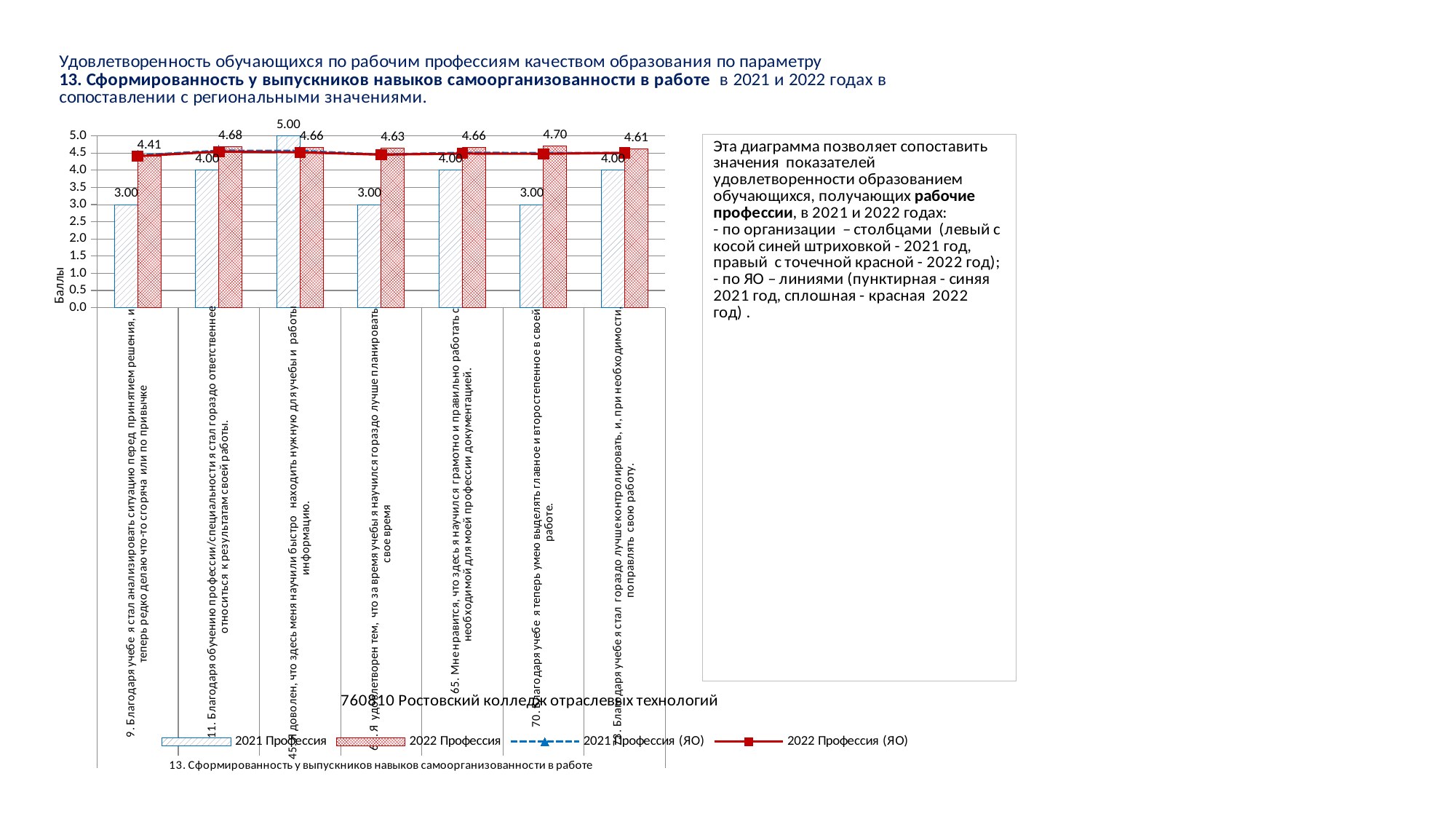
What is the value of the 2022 Профессия bar for category 9 (Благодаря учебе я стал анализировать ситуацию перед принятием решения)? 4.41 How many series does the chart legend list? 4 For category 9, what is the difference between the 2022 Профессия value and the 2021 Профессия value? 1.41 What is the value of the 2021 Профессия bar for category 45 (Я доволен, что здесь меня научили быстро находить нужную информацию)? 5.00 What is the value of the 2022 Профессия bar for category 65 (Мне нравится, что здесь я научился грамотно и правильно работать с документацией)? 4.66 What is the title of the vertical axis of the chart? Баллы For category 11, which is larger: the 2021 Профессия value or the 2022 Профессия value? 2022 Профессия For category 45, what is the difference between the 2021 Профессия value and the 2022 Профессия value? 0.34 Is the 2021 Профессия (ЯО) line value for category 9 greater or less than 4.0? greater How many categories are shown on the x axis of the chart? 7 Which category has the highest 2022 Профессия value? 70. Благодаря учебе я теперь умею выделять главное и второстепенное в своей работе (4.70) Which category has the lowest 2022 Профессия value? 9. Благодаря учебе я стал анализировать ситуацию перед принятием решения (4.41)